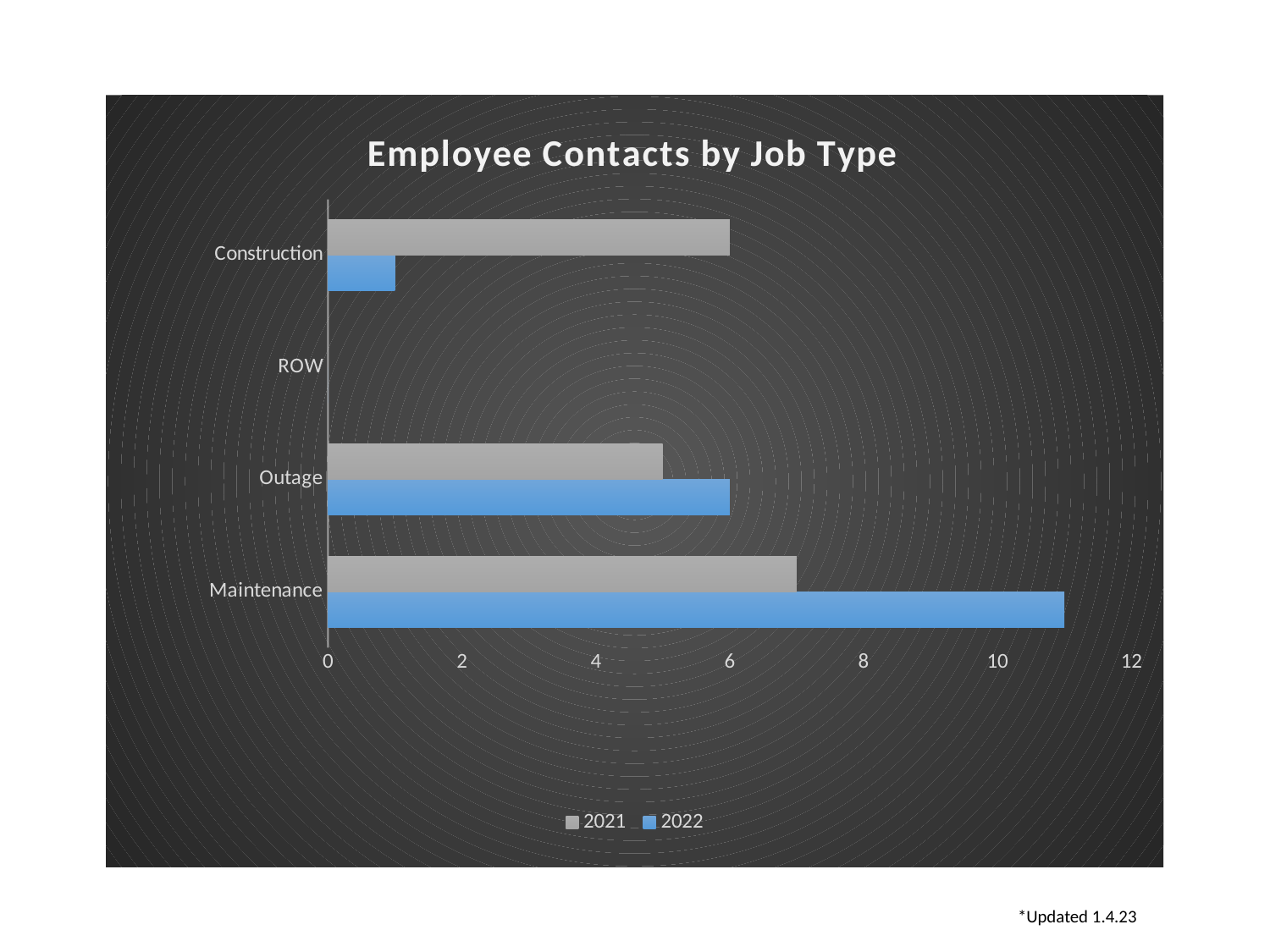
Which job type has the highest 2022 value? Maintenance How many job type categories are shown on the vertical axis? 4 Is the 2022 value for Construction greater or less than 2? less What is the title of the chart? Employee Contacts by Job Type For Maintenance, which series has the larger value, 2021 or 2022? 2022 For Construction, which series has the larger value, 2021 or 2022? 2021 What kind of chart is shown on the slide? bar chart Is the 2022 value for Maintenance greater or less than 10? greater Which job type has the highest 2021 value? Maintenance What is the 2022 value for Outage? 6 How many series does the legend list? 2 What is the 2021 value for Construction? 6